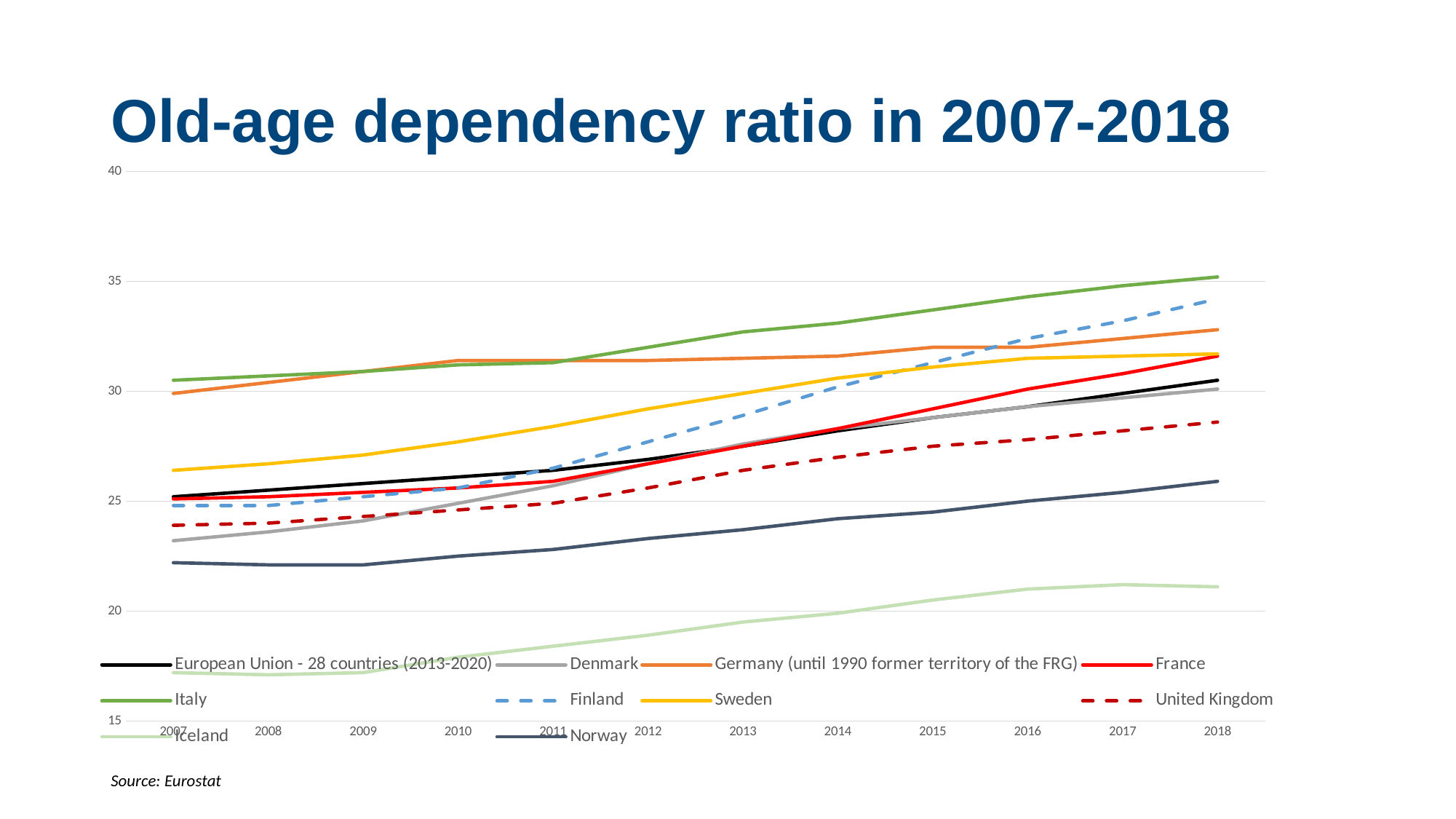
How many series does the legend list? 10 Is the value for United Kingdom in 2018 greater or less than 30? less Which country has the highest old-age dependency ratio in 2018? Italy Is the value for Finland in 2018 greater or less than 30? greater Which country has the lowest old-age dependency ratio in 2018? Iceland What kind of chart is shown on the slide? line chart Which country has the lowest old-age dependency ratio in 2007? Iceland How many years are plotted along the x axis? 12 Which is larger in 2018, the value for Denmark or the value for Norway? Denmark Is the value for Iceland in 2018 greater or less than 25? less What is the source cited for the chart? Eurostat Does the old-age dependency ratio for Italy rise or fall from 2007 to 2018? rise